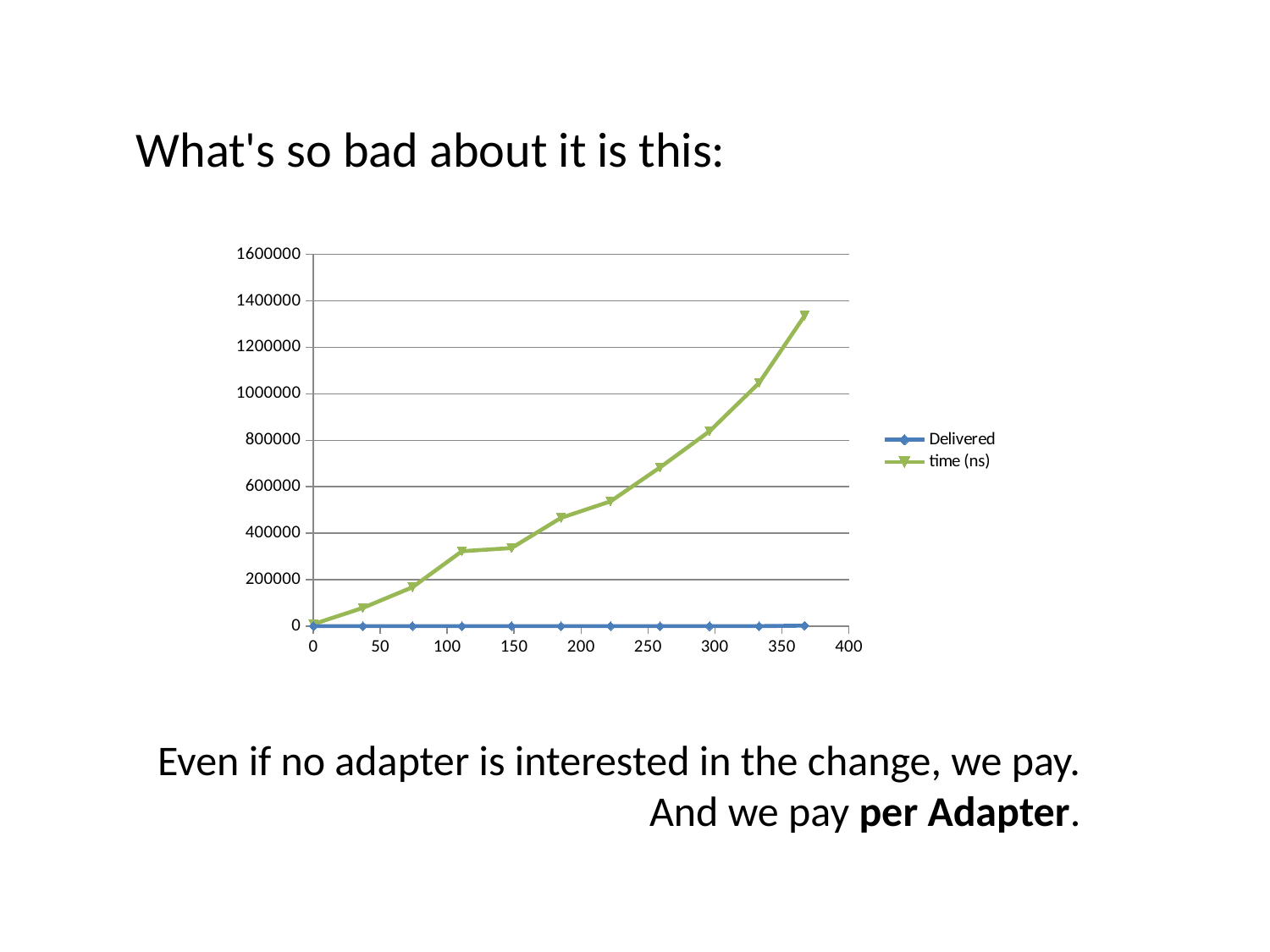
Which series reaches the highest value on the chart? time (ns) Is the value of the rightmost time (ns) point greater or less than 1200000? greater What is the highest value shown on the y axis? 1600000 How many series does the legend list? 2 What kind of chart is shown on the slide? line chart Is the time (ns) value at x = 300 greater or less than 600000? greater How many data points are plotted for the time (ns) series? 11 Is the value of the rightmost time (ns) point greater or less than 1400000? less Which series stays lowest across the whole x axis? Delivered At the rightmost plotted point, which series has the larger value, Delivered or time (ns)? time (ns) What are the two series named in the legend? Delivered and time (ns) Does the time (ns) series rise or fall as the x axis increases? rise